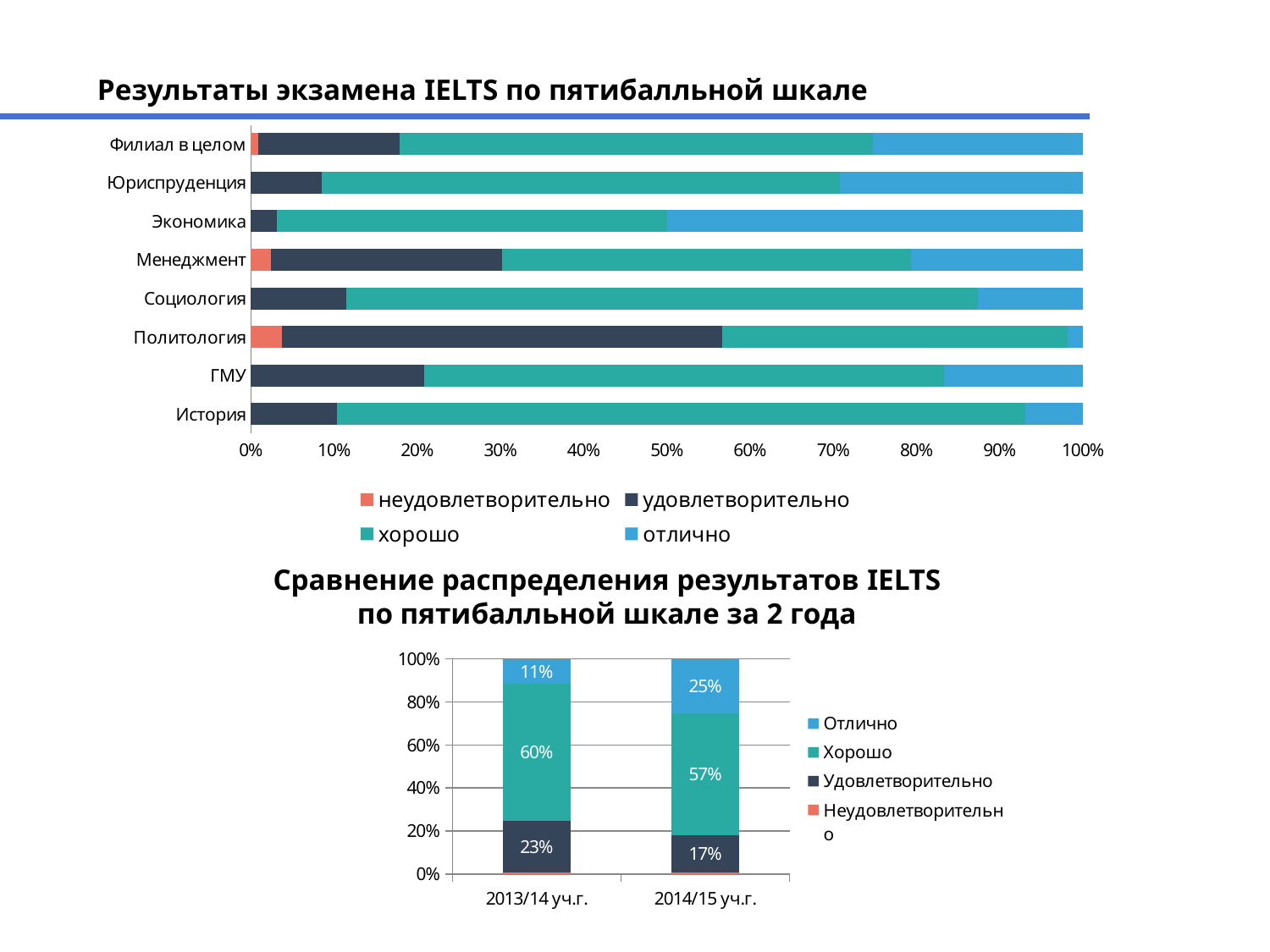
In the bottom chart 'Сравнение распределения результатов IELTS по пятибалльной шкале за 2 года', what is the 'Отлично' share for 2014/15 уч.г.? 25% In the top chart 'Результаты экзамена IELTS по пятибалльной шкале', which programme has the largest 'удовлетворительно' share? Политология In the top chart 'Результаты экзамена IELTS по пятибалльной шкале', how many categories (programmes) are shown on the vertical axis? 8 In the top chart 'Результаты экзамена IELTS по пятибалльной шкале', is the 'отлично' share for Экономика greater or less than 40%? greater In the top chart 'Результаты экзамена IELTS по пятибалльной шкале', is the 'удовлетворительно' share for Менеджмент greater or less than 20%? greater In the top chart 'Результаты экзамена IELTS по пятибалльной шкале', how many series does the legend list? 4 In the bottom chart 'Сравнение распределения результатов IELTS по пятибалльной шкале за 2 года', what is the 'Удовлетворительно' share for 2014/15 уч.г.? 17% In the bottom chart 'Сравнение распределения результатов IELTS по пятибалльной шкале за 2 года', what is the 'Хорошо' share for 2013/14 уч.г.? 60% In the top chart 'Результаты экзамена IELTS по пятибалльной шкале', which programme has the largest 'отлично' share? Экономика In the bottom chart 'Сравнение распределения результатов IELTS по пятибалльной шкале за 2 года', by how many percentage points did the 'Отлично' share change from 2013/14 уч.г. to 2014/15 уч.г.? 14 percentage points What kind of chart is the top chart titled 'Результаты экзамена IELTS по пятибалльной шкале'? Stacked bar chart In the bottom chart 'Сравнение распределения результатов IELTS по пятибалльной шкале за 2 года', which year has the larger 'Хорошо' share, 2013/14 уч.г. or 2014/15 уч.г.? 2013/14 уч.г.